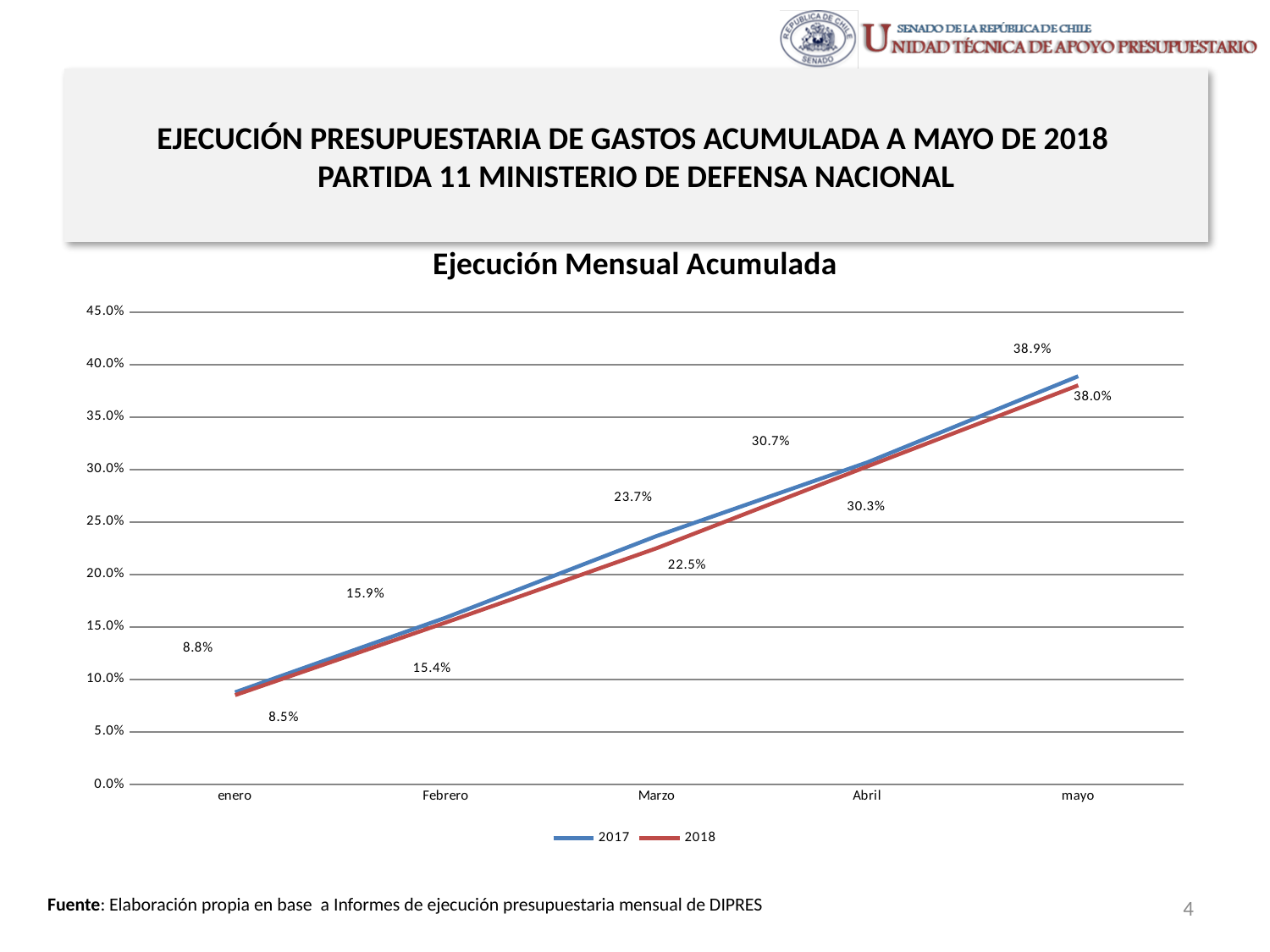
What is the difference between the 2017 and 2018 values in mayo? 0.9% Which series has the higher value in Marzo, 2017 or 2018? 2017 What is the value for 2017 in Abril? 30.7% What is the value for 2018 in enero? 8.5% What type of chart is shown on the slide? line chart How many months are shown on the x axis? 5 What is the value for 2017 in mayo? 38.9% In which month is the 2018 series at its lowest? enero What is the title of the chart? Ejecución Mensual Acumulada Do the values for 2017 rise or fall from enero to mayo? rise How many series does the legend list? 2 What is the value for 2018 in Marzo? 22.5%